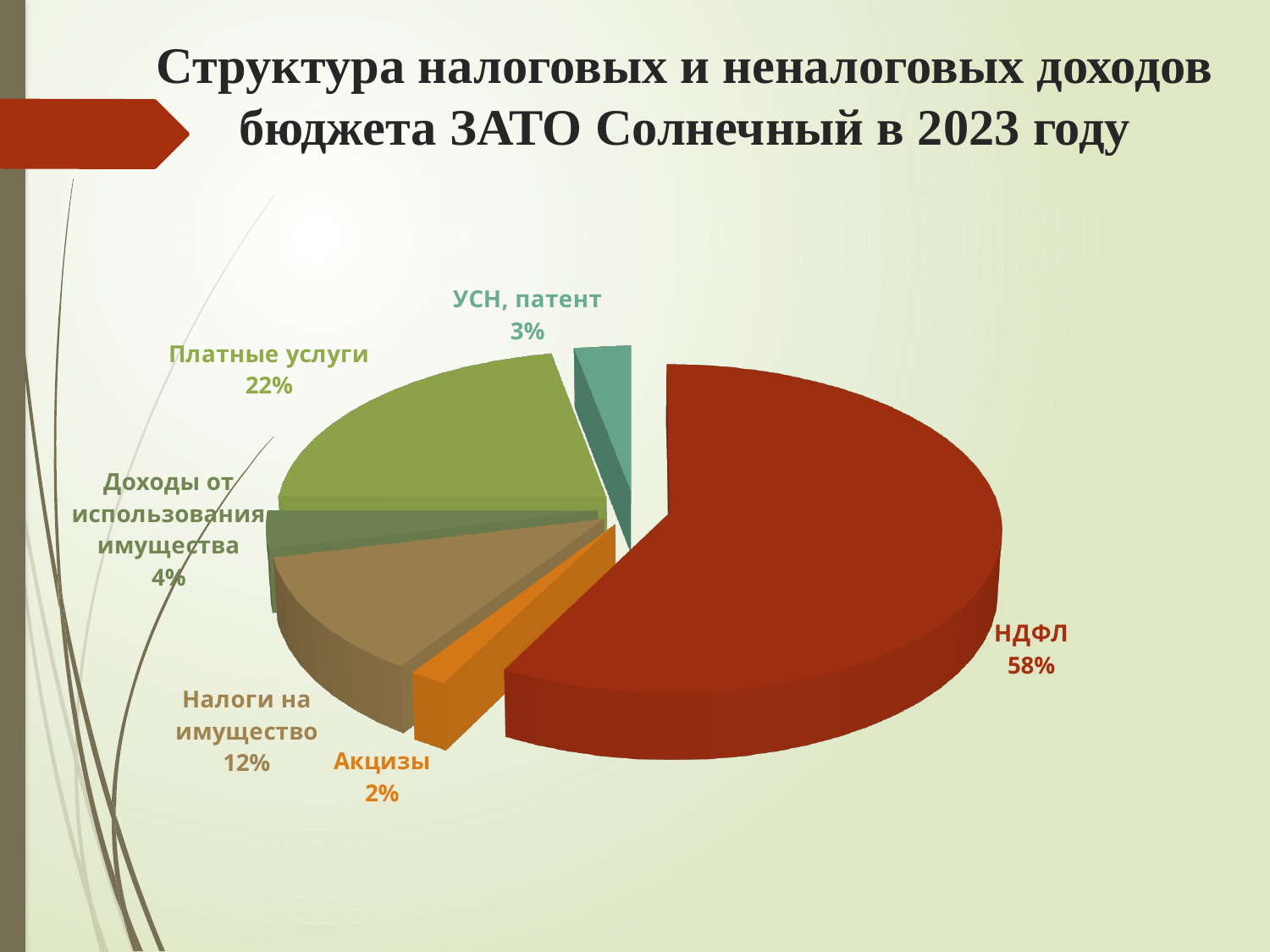
What share of the pie does НДФЛ account for? 58% What is the title of the slide? Структура налоговых и неналоговых доходов бюджета ЗАТО Солнечный в 2023 году Which category has the smallest share of the pie? Акцизы What is the difference in percentage points between НДФЛ and Платные услуги? 36 Which is larger, Налоги на имущество or Доходы от использования имущества? Налоги на имущество Which category has the largest share of the pie? НДФЛ What is the value shown for Налоги на имущество? 12% How many categories are shown in the pie chart? 6 What is the value shown for Платные услуги? 22% What kind of chart is shown on the slide? Pie chart What is the value shown for Доходы от использования имущества? 4% What is the value shown for УСН, патент? 3%